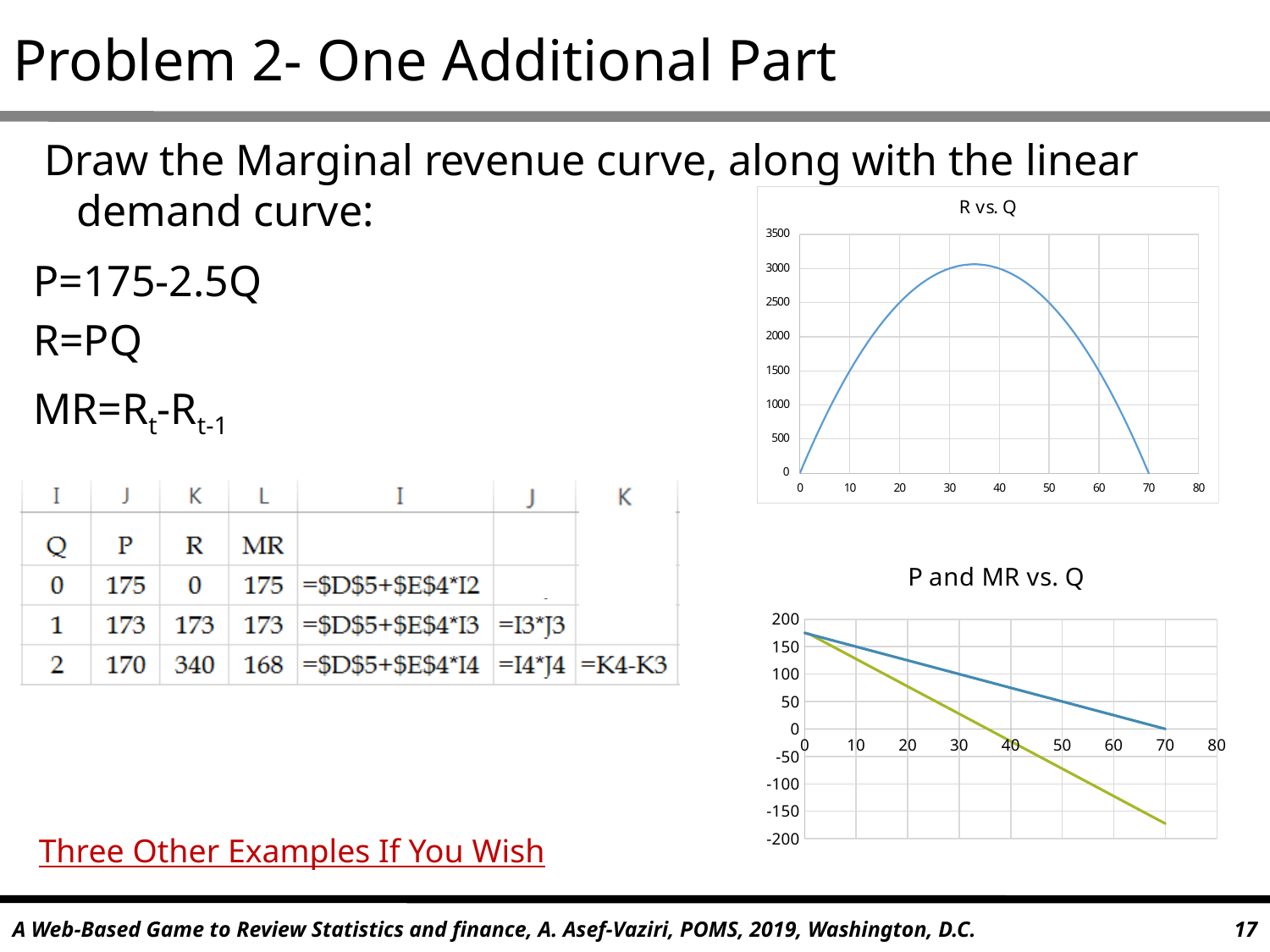
How many lines are plotted in the 'P and MR vs. Q' chart? 2 In the 'P and MR vs. Q' chart, do the lines rise or fall as Q increases? fall In the 'P and MR vs. Q' chart, at Q=40, which line is higher, the blue line or the green line? the blue line In the 'R vs. Q' chart, is the value at Q=40 greater or less than 2500? greater In the 'R vs. Q' chart, is the peak value of the curve greater or less than 3500? less In the 'P and MR vs. Q' chart, is the value of the green line at Q=70 greater or less than -150? less What kind of chart is the 'R vs. Q' chart? line chart What kind of chart is the 'P and MR vs. Q' chart? line chart In the 'R vs. Q' chart, does the curve rise or fall as Q goes from 40 to 70? fall In the 'R vs. Q' chart, does the curve rise or fall as Q goes from 0 to 30? rise